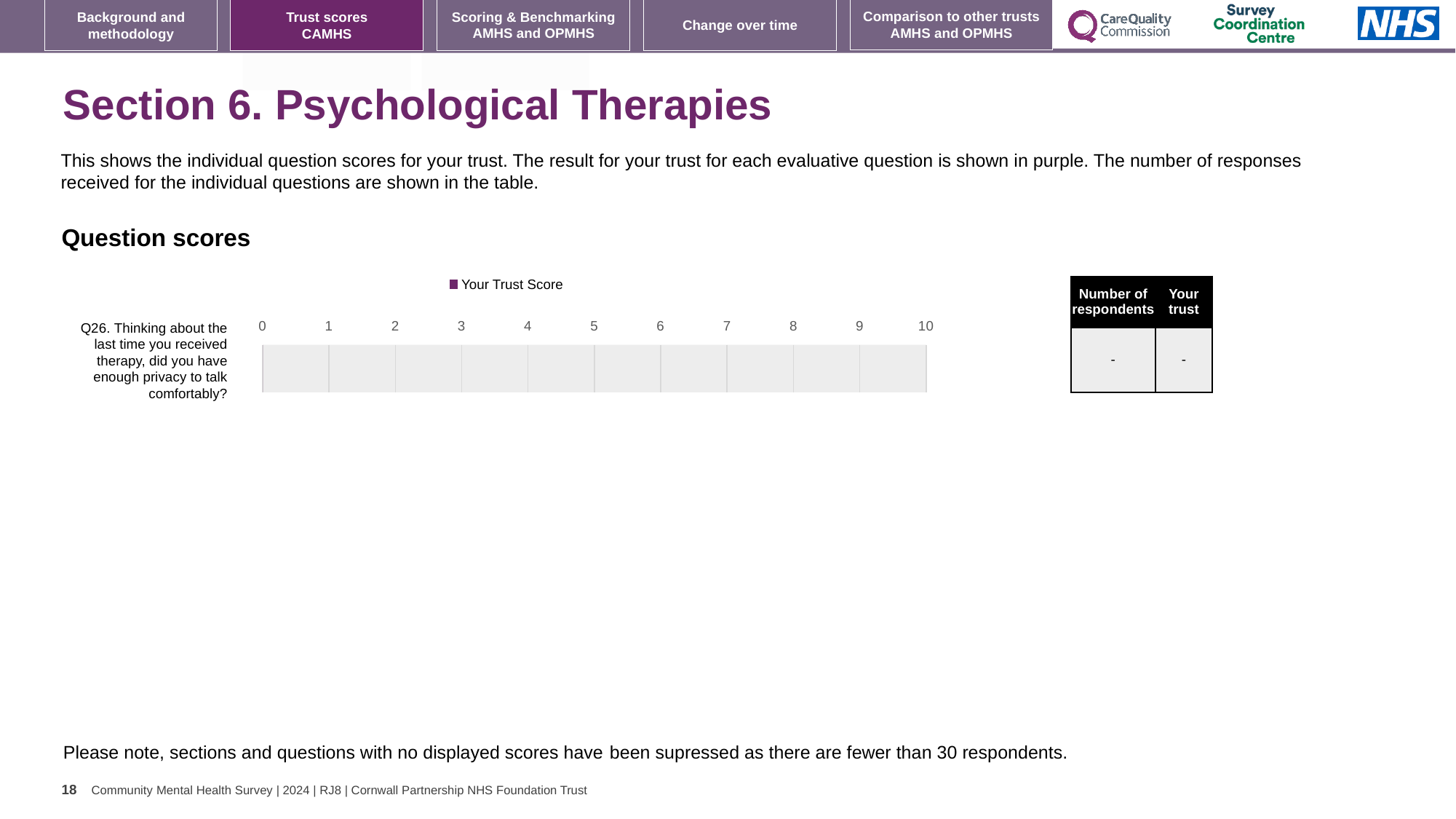
How many series does the chart legend list? 1 What is the highest value shown on the chart's horizontal axis? 10 What kind of chart is shown under "Question scores"? bar chart What is the name of the series shown in the chart legend? Your Trust Score How many questions (categories) are listed on the chart's axis? 1 Which question is plotted on the chart? Q26. Thinking about the last time you received therapy, did you have enough privacy to talk comfortably?